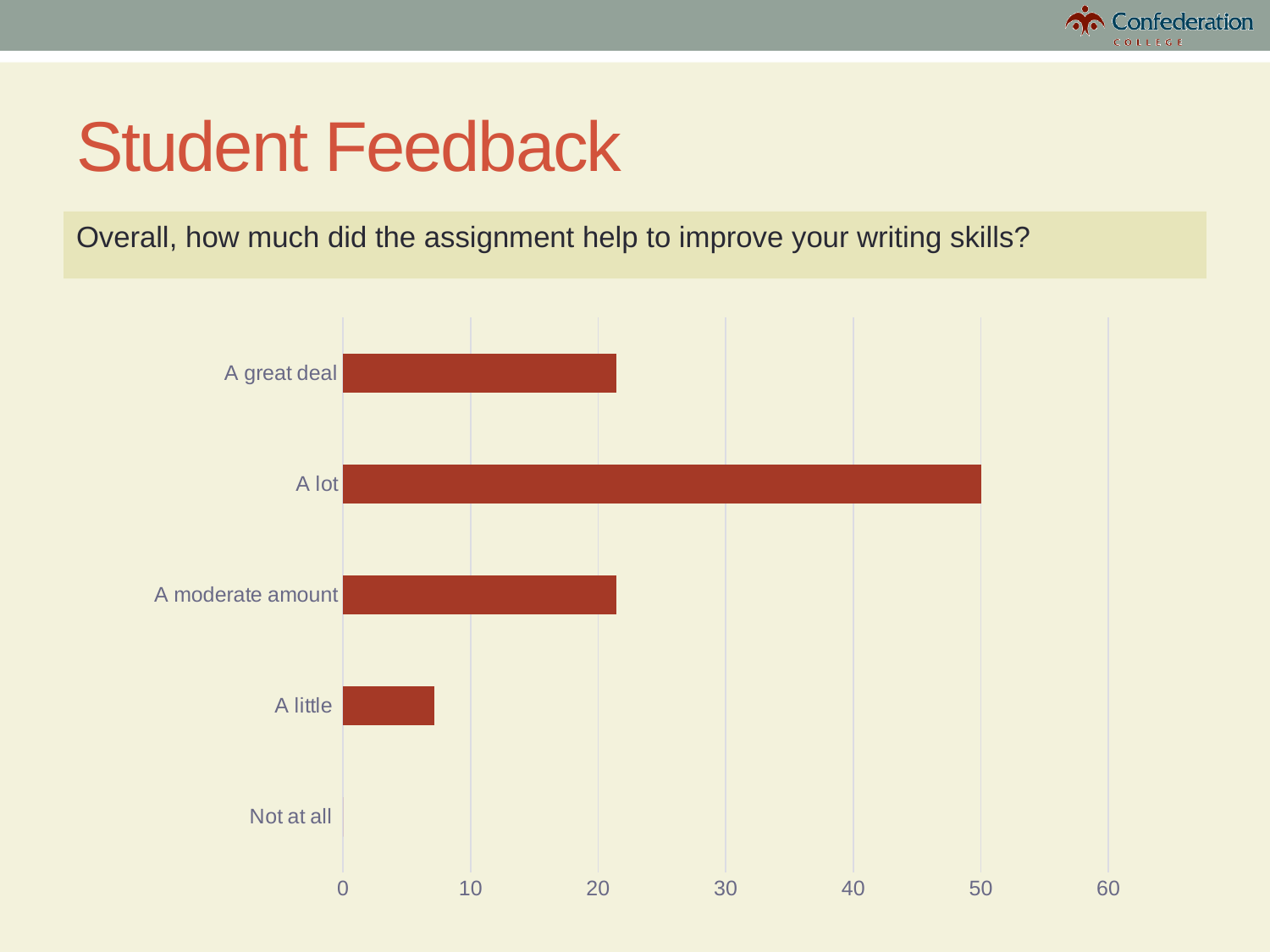
What kind of chart is shown on the slide? bar chart Is the value for "A moderate amount" greater or less than 30? less How many response categories are shown on the chart? 5 Is the value for "A little" greater or less than 10? less What survey question does the chart present responses to? Overall, how much did the assignment help to improve your writing skills? Which is larger, the value for "A lot" or the value for "A little"? A lot What is the value for "A lot"? 50 Is the value for "A lot" greater or less than 40? greater What is the value for "Not at all"? 0 Which is larger, the value for "A great deal" or the value for "A little"? A great deal Which response category has the lowest value? Not at all Which response category has the highest value? A lot